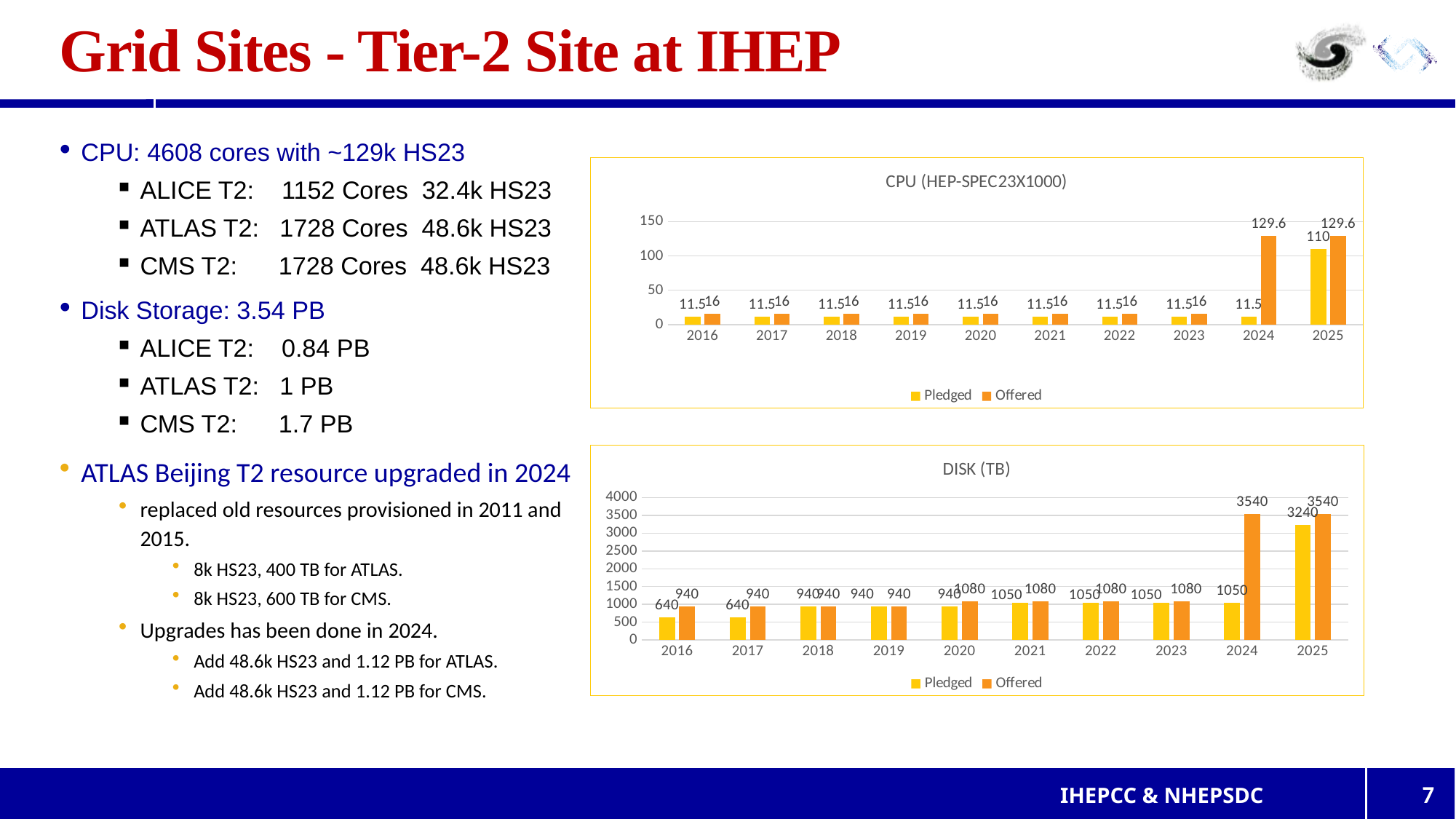
In the DISK (TB) chart, which year has the lowest Pledged value? 2016 and 2017 In the CPU (HEP-SPEC23X1000) chart, what is the Offered value for 2024? 129.6 In the DISK (TB) chart, what is the Offered value for 2024? 3540 In the DISK (TB) chart, is the Pledged value for 2025 greater or less than 3000? greater In the CPU (HEP-SPEC23X1000) chart, how many years are shown on the x axis? 10 In the DISK (TB) chart, what is the Pledged value for 2016? 640 In the CPU (HEP-SPEC23X1000) chart, how many series does the legend list? 2 In the CPU (HEP-SPEC23X1000) chart, what is the Pledged value for 2025? 110 In the CPU (HEP-SPEC23X1000) chart, what is the difference between the Offered and Pledged values in 2025? 19.6 In the DISK (TB) chart, what is the difference between the Offered and Pledged values in 2025? 300 What kind of chart is the DISK (TB) chart? Bar chart In the CPU (HEP-SPEC23X1000) chart, what is the Offered value for 2019? 16